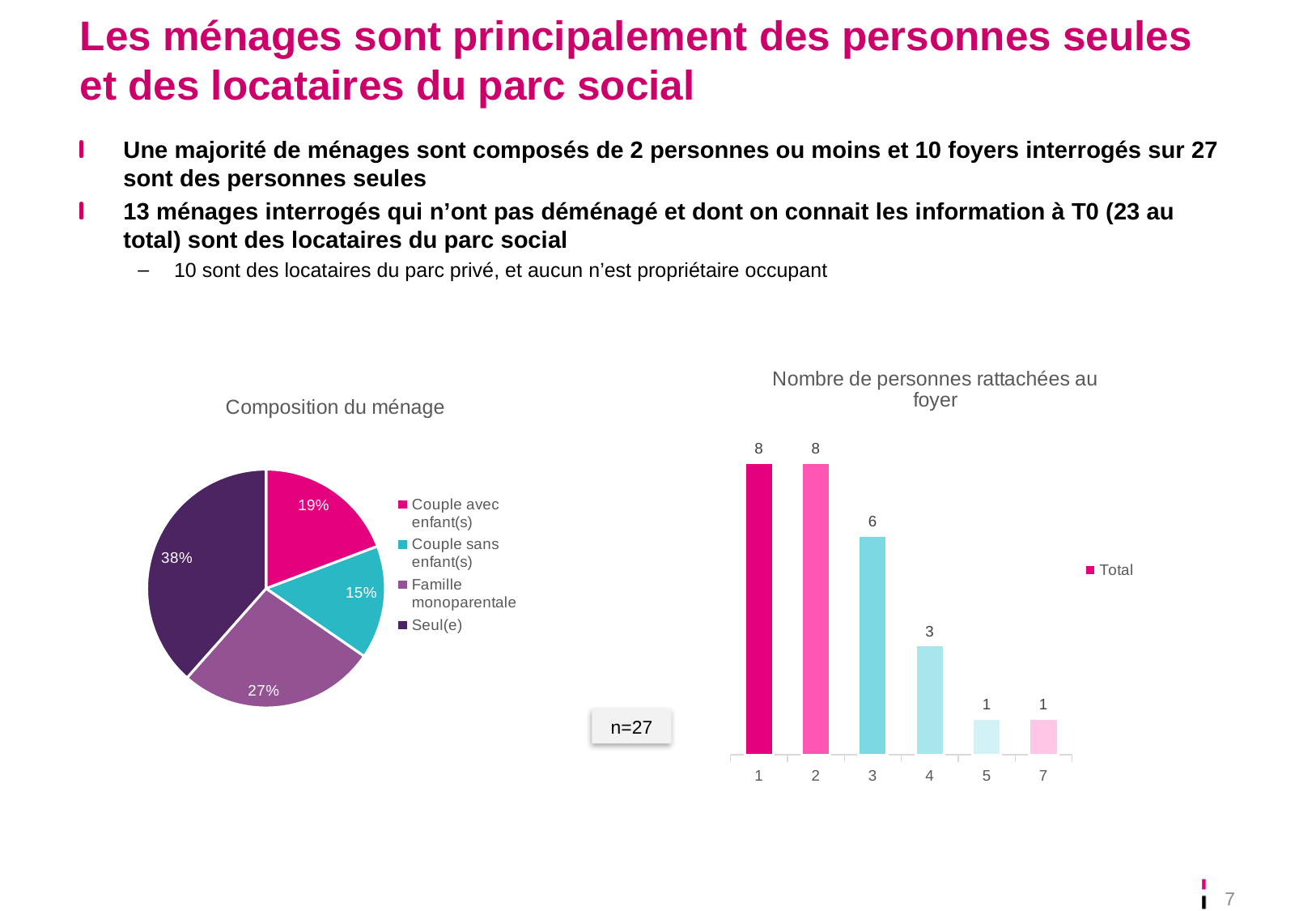
In the 'Composition du ménage' chart, what is the difference in percentage points between 'Famille monoparentale' and 'Couple avec enfant(s)'? 8 percentage points In the 'Composition du ménage' chart, which category has the smallest share? Couple sans enfant(s) What is the only series listed in the legend of the 'Nombre de personnes rattachées au foyer' chart? Total In the 'Nombre de personnes rattachées au foyer' chart, how many categories are shown on the x axis? 6 In the 'Nombre de personnes rattachées au foyer' chart, what is the value for category 4? 3 In the 'Composition du ménage' chart, what share of households are 'Seul(e)'? 38% In the 'Composition du ménage' chart, what share of households are 'Couple sans enfant(s)'? 15% In the 'Nombre de personnes rattachées au foyer' chart, what is the value for category 3? 6 What kind of chart is 'Composition du ménage'? Pie chart In the 'Composition du ménage' chart, which category has the largest share? Seul(e) In the 'Nombre de personnes rattachées au foyer' chart, do the values rise or fall as you move from category 1 to category 7 along the x axis? Fall In the 'Nombre de personnes rattachées au foyer' chart, what is the difference between the values for category 2 and category 4? 5